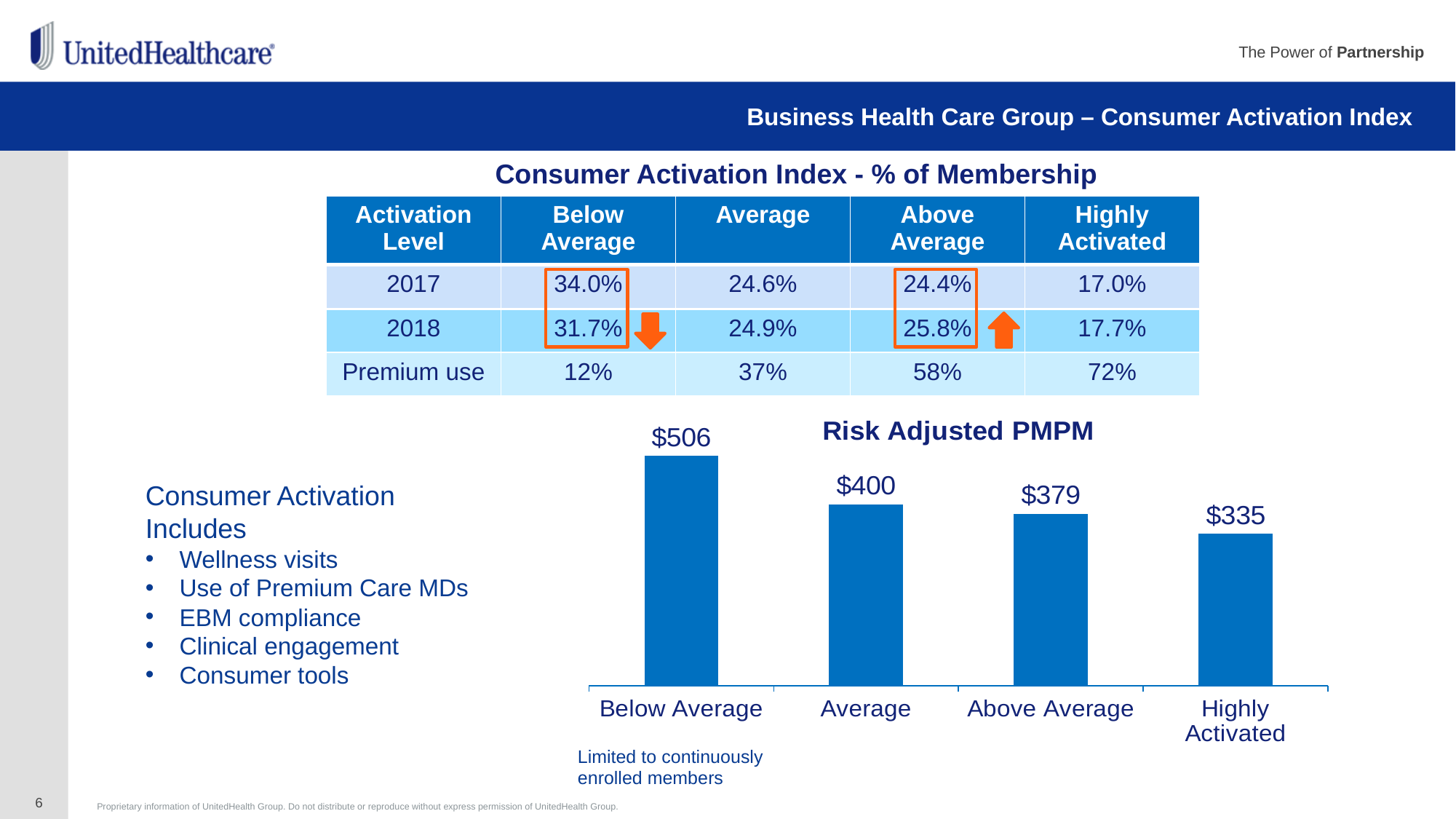
Which activation level has the highest Risk Adjusted PMPM? Below Average How many activation levels are shown in the Risk Adjusted PMPM chart? 4 Which activation level has the lowest Risk Adjusted PMPM? Highly Activated What kind of chart is the Risk Adjusted PMPM chart? Bar chart What is the difference in Risk Adjusted PMPM between Below Average and Highly Activated? $171 What is the Risk Adjusted PMPM value for Below Average? $506 What is the Risk Adjusted PMPM value for Above Average? $379 Do the Risk Adjusted PMPM values rise or fall from Below Average to Highly Activated? Fall Which has a larger Risk Adjusted PMPM, Average or Above Average? Average What is the difference in Risk Adjusted PMPM between Average and Above Average? $21 What is the Risk Adjusted PMPM value for Highly Activated? $335 What is the Risk Adjusted PMPM value for Average? $400